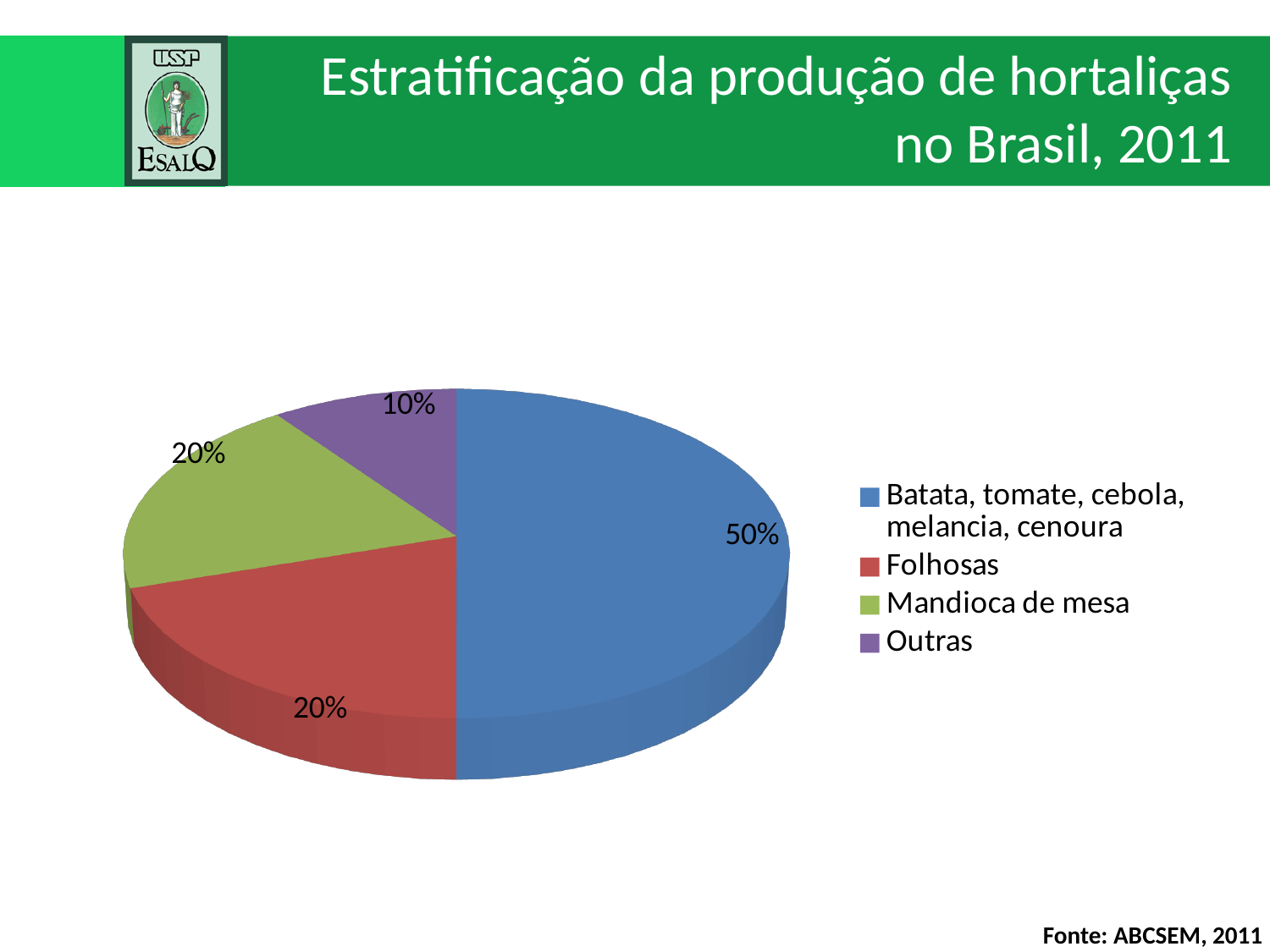
What kind of chart is shown on the slide? pie chart What share of the pie does the 'Mandioca de mesa' slice represent? 20% What colour is the 'Mandioca de mesa' slice in the pie chart? green Which category has the smallest slice of the pie? Outras What share of the pie does the 'Folhosas' slice represent? 20% How many categories does the pie chart show? 4 Which category has the largest slice of the pie? Batata, tomate, cebola, melancia, cenoura What share of the pie does the 'Outras' slice represent? 10% What is the difference in percentage points between the 'Batata, tomate, cebola, melancia, cenoura' slice and the 'Outras' slice? 40 percentage points Which is larger, the 'Folhosas' slice or the 'Outras' slice? Folhosas What is the title of the slide containing the chart? Estratificação da produção de hortaliças no Brasil, 2011